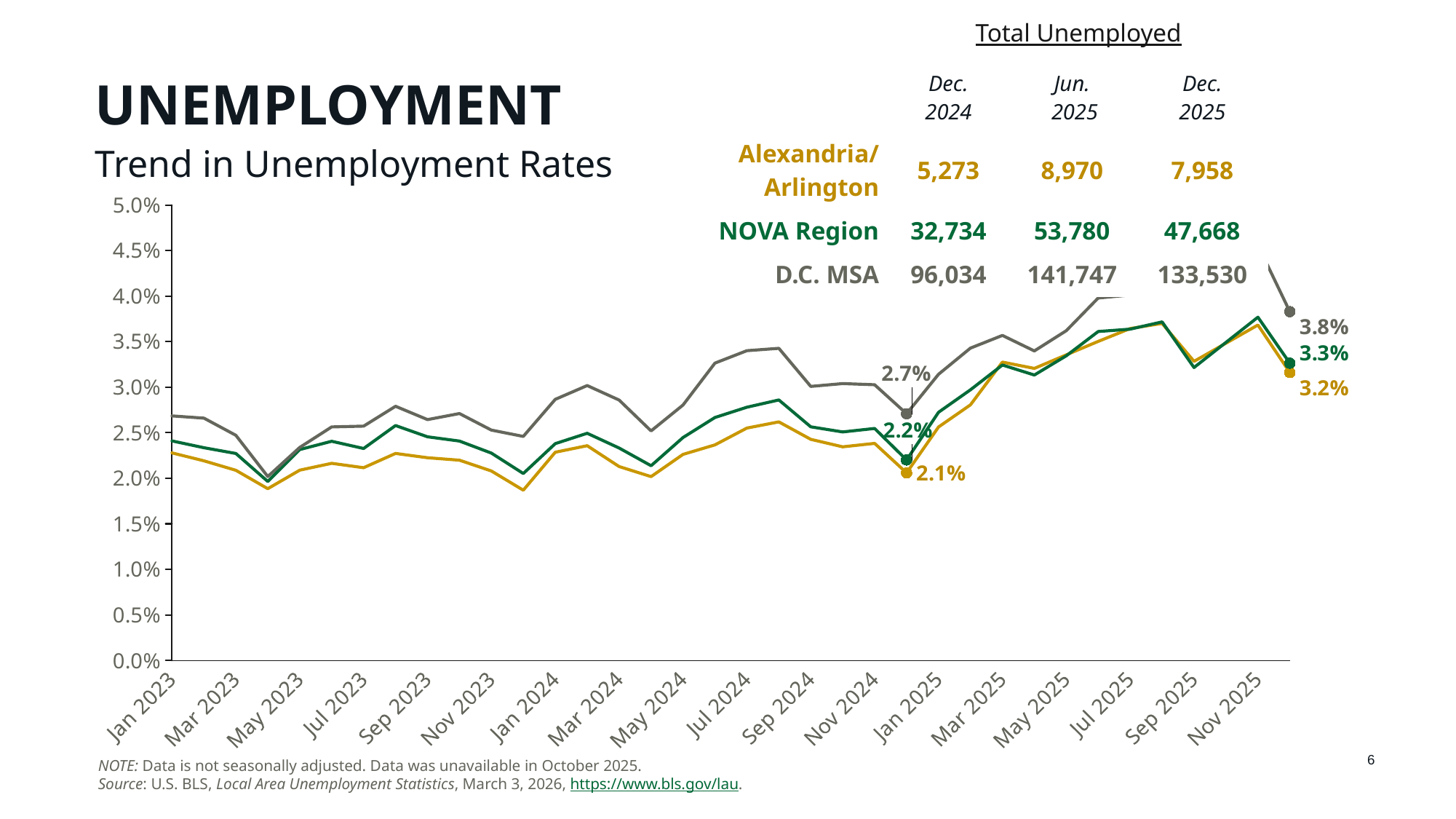
How many lines (areas) are plotted on the chart? 3 At Dec 2024, which labelled rate is higher: NOVA Region or Alexandria/Arlington? NOVA Region What is the D.C. MSA unemployment rate labelled at the end of the line (Dec 2025)? 3.8% What is the D.C. MSA unemployment rate labelled at Dec 2024? 2.7% What is the Alexandria/Arlington unemployment rate labelled at Dec 2024? 2.1% Which area has the highest labelled unemployment rate at Dec 2025? D.C. MSA By how many percentage points did the D.C. MSA rate rise from its Dec 2024 label to its Dec 2025 label? 1.1 percentage points What kind of chart is shown on the slide? line chart What is the NOVA Region unemployment rate labelled at the end of the line (Dec 2025)? 3.3% Overall, do the unemployment rates rise or fall from Jan 2023 to the end of 2025? rise Is the D.C. MSA value around Jul 2025 greater or less than 3.5%? greater What is the difference between the D.C. MSA and Alexandria/Arlington labelled rates at Dec 2025? 0.6 percentage points